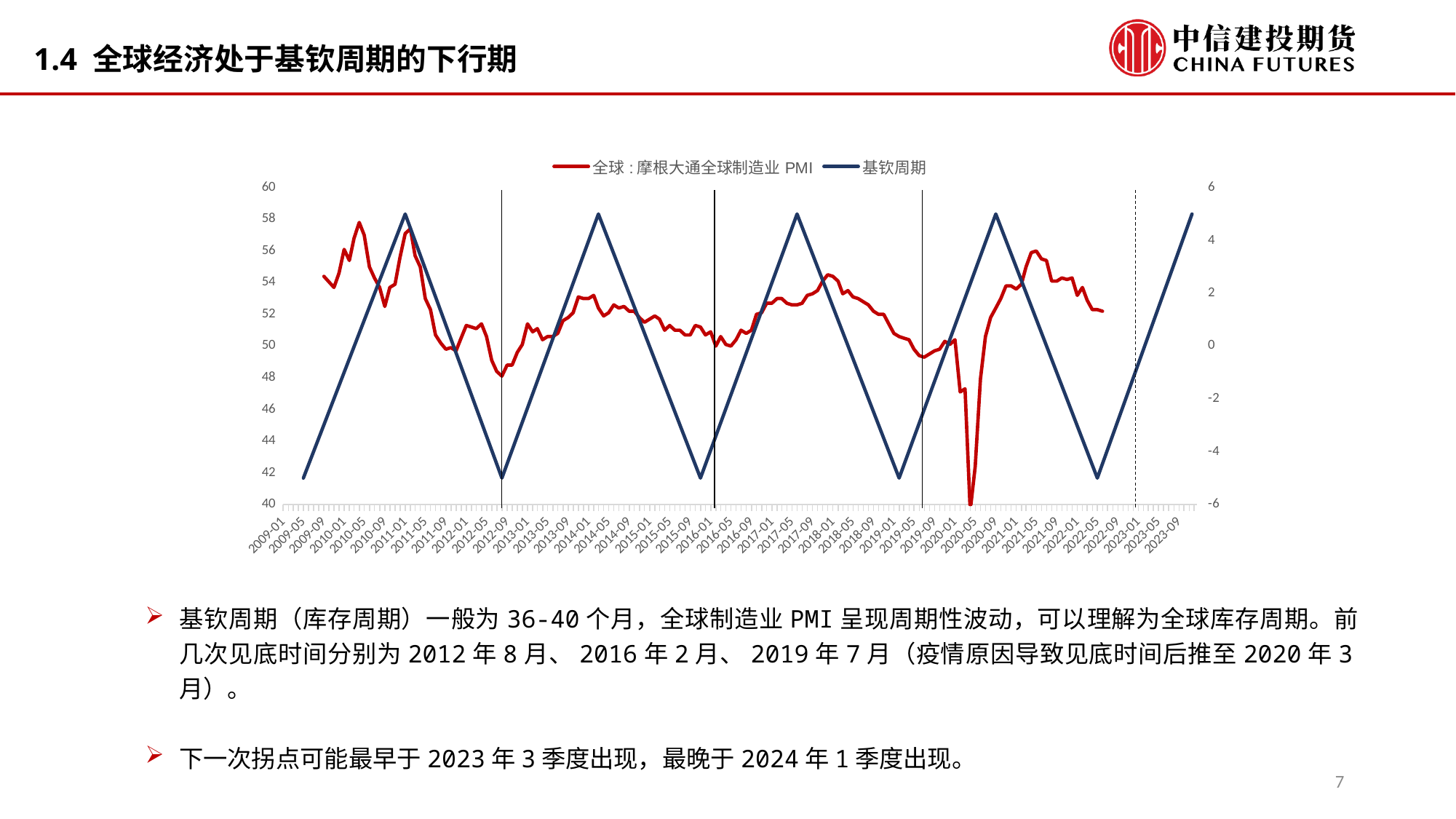
What are the two series named in the chart legend? 全球:摩根大通全球制造业 PMI and 基钦周期 Is the value of 全球:摩根大通全球制造业 PMI around 2012-09 greater or less than 50? less Is the value of 全球:摩根大通全球制造业 PMI around 2021-05 greater or less than 54? greater Does the 全球:摩根大通全球制造业 PMI line rise or fall from 2021-05 to 2022-05? fall Which is lower, the 全球:摩根大通全球制造业 PMI value around 2020-05 or around 2012-09? 2020-05 What kind of chart is shown on the slide? line chart How many series does the chart legend list? 2 Is the value of 基钦周期 around 2019-05 greater or less than -4 on the right axis? greater What colour is the line for 全球:摩根大通全球制造业 PMI? red In which year does the 全球:摩根大通全球制造业 PMI line reach its lowest point? 2020 Does the 基钦周期 line rise or fall from 2019-09 to 2020-09? rise